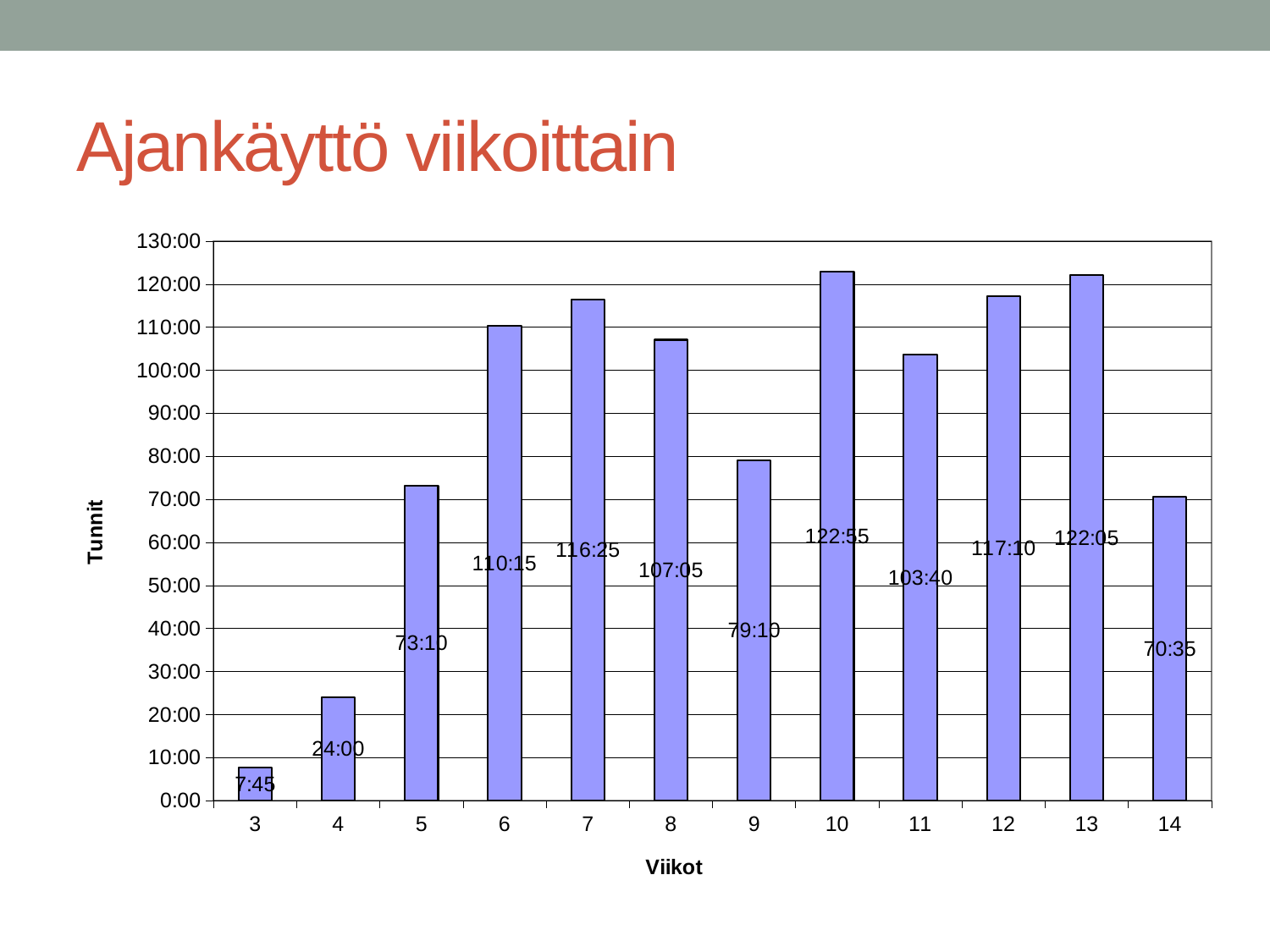
What is the value for week 3? 7:45 What is the difference between the values for week 6 and week 8? 3:10 Which week has the lowest value? 3 What is the title of the chart? Ajankäyttö viikoittain What is the difference between the values for week 4 and week 3? 16:15 What kind of chart is shown on the slide? Bar chart What is the value for week 14? 70:35 Which is larger, the value for week 9 or the value for week 5? Week 9 What is the value for week 10? 122:55 What is the value for week 8? 107:05 How many weeks are shown on the x axis? 12 Which week has the highest value? 10